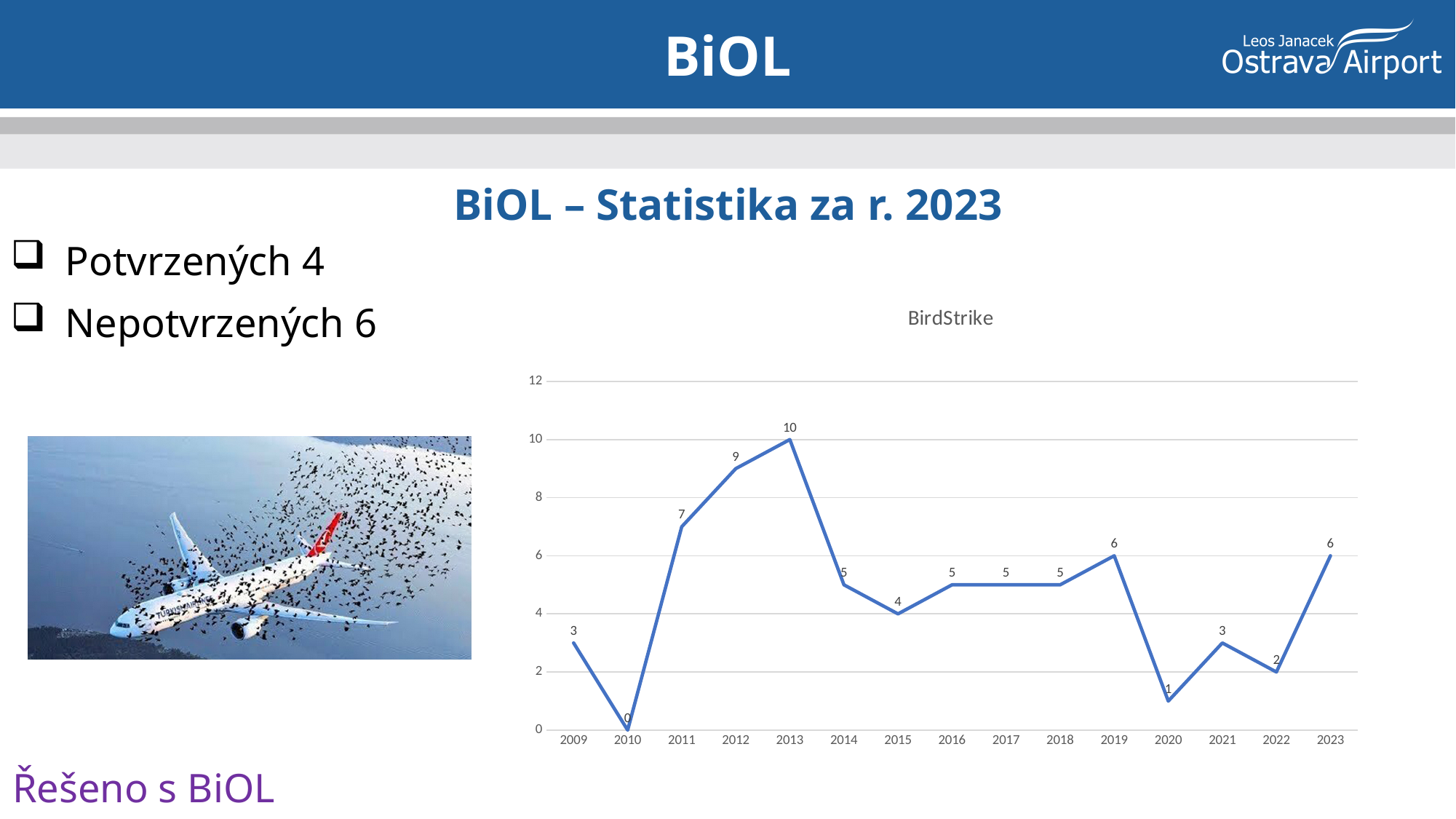
What is the difference between the BirdStrike values for 2022 and 2023? 4 What is the difference between the BirdStrike values for 2013 and 2014? 5 Which year has a larger BirdStrike value, 2019 or 2021? 2019 Do the BirdStrike values rise or fall from 2020 to 2023? rise What is the title of the chart? BirdStrike What kind of chart is the BirdStrike chart? line chart What is the BirdStrike value for 2010? 0 What is the BirdStrike value for 2023? 6 Which year has the lowest BirdStrike value? 2010 What is the BirdStrike value for 2013? 10 How many years are plotted on the BirdStrike chart? 15 Which year has the highest BirdStrike value? 2013